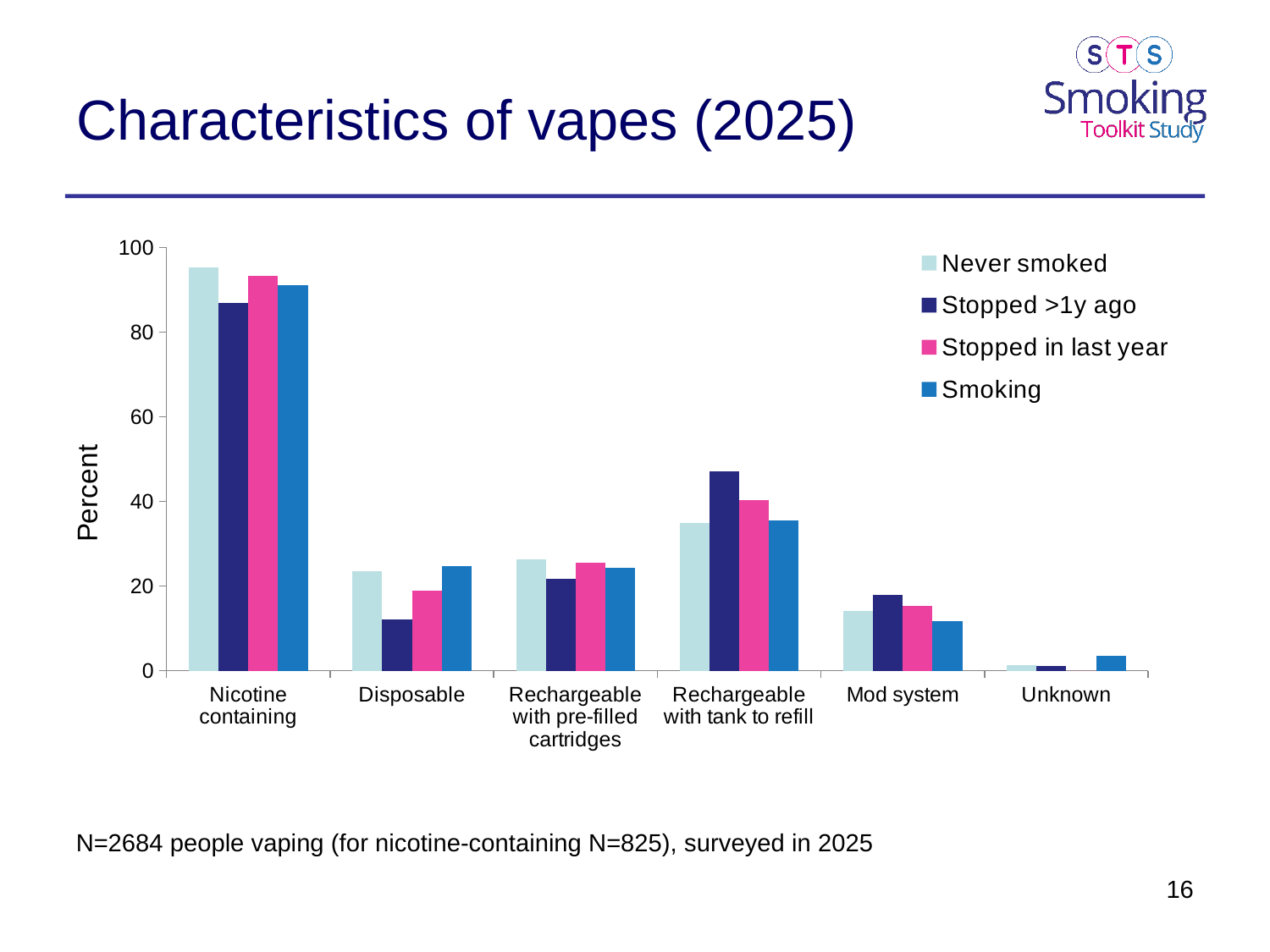
Is the value for Never smoked in the Nicotine containing category greater or less than 80? greater Which category has the highest values across all series? Nicotine containing In the Rechargeable with tank to refill category, which series has the highest value? Stopped >1y ago How many categories are shown along the x axis? 6 In the Nicotine containing category, which is larger: Never smoked or Stopped >1y ago? Never smoked Is the value for Smoking in the Mod system category greater or less than 20? less Is the value for Stopped >1y ago in the Disposable category greater or less than 20? less What is the label on the y axis? Percent How many series does the legend list? 4 In the Disposable category, which series has the lowest value? Stopped >1y ago What kind of chart is shown on the slide? bar chart